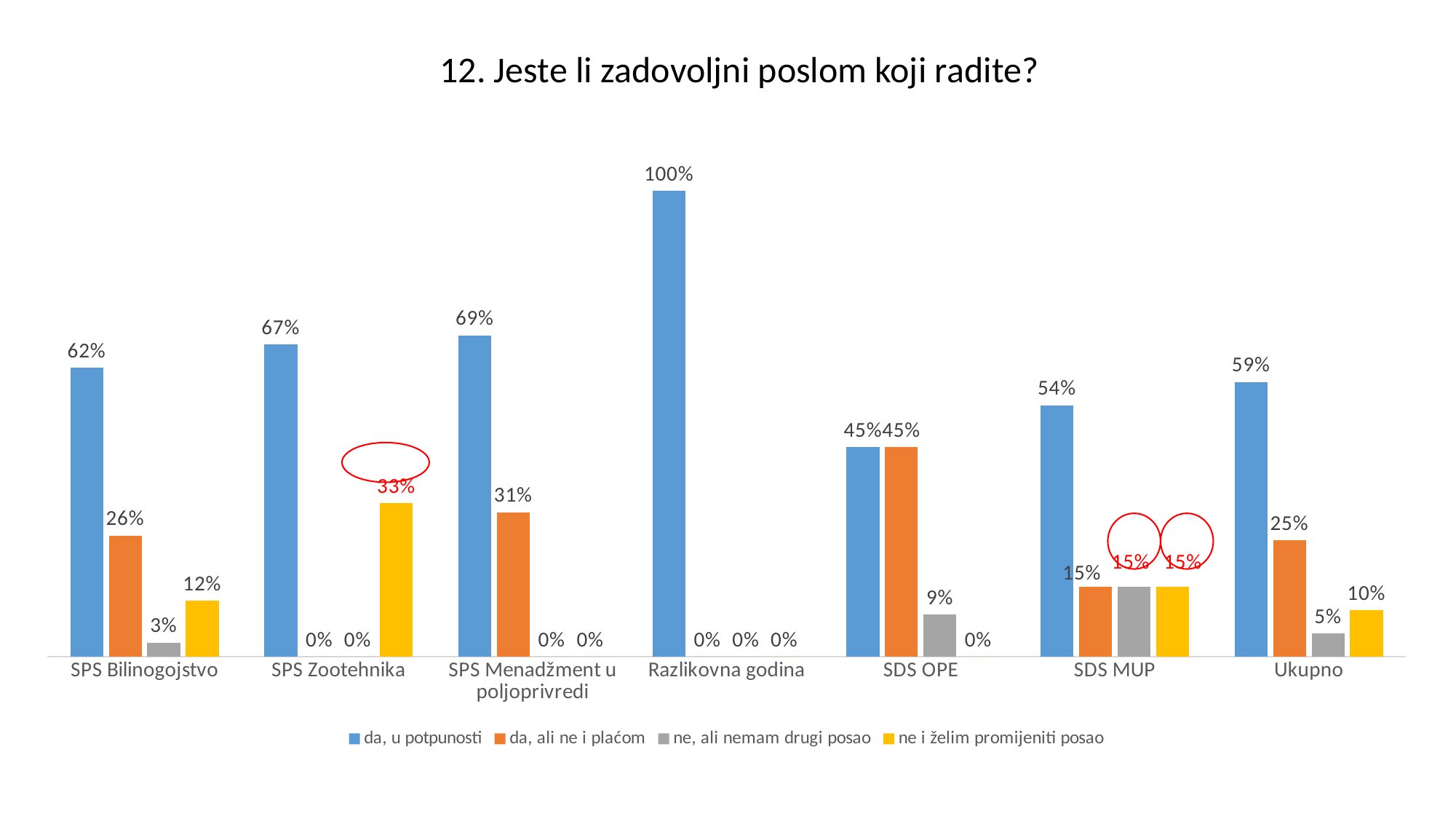
What is the value for "ne i želim promijeniti posao" for SPS Zootehnika? 33% Which category has the lowest value for "da, u potpunosti"? SDS OPE How many categories are shown on the x axis? 7 Which category has the highest value for "da, u potpunosti"? Razlikovna godina What is the title of the chart? 12. Jeste li zadovoljni poslom koji radite? What is the value for "da, ali ne i plaćom" for Ukupno? 25% Which is larger for SDS MUP: "da, u potpunosti" or "da, ali ne i plaćom"? da, u potpunosti How many series does the legend list? 4 What kind of chart is shown on the slide? bar chart What is the value for "da, u potpunosti" for SPS Bilinogojstvo? 62% What is the difference between the "da, u potpunosti" values for SPS Menadžment u poljoprivredi and SPS Bilinogojstvo? 7% What is the value for "ne, ali nemam drugi posao" for SDS OPE? 9%